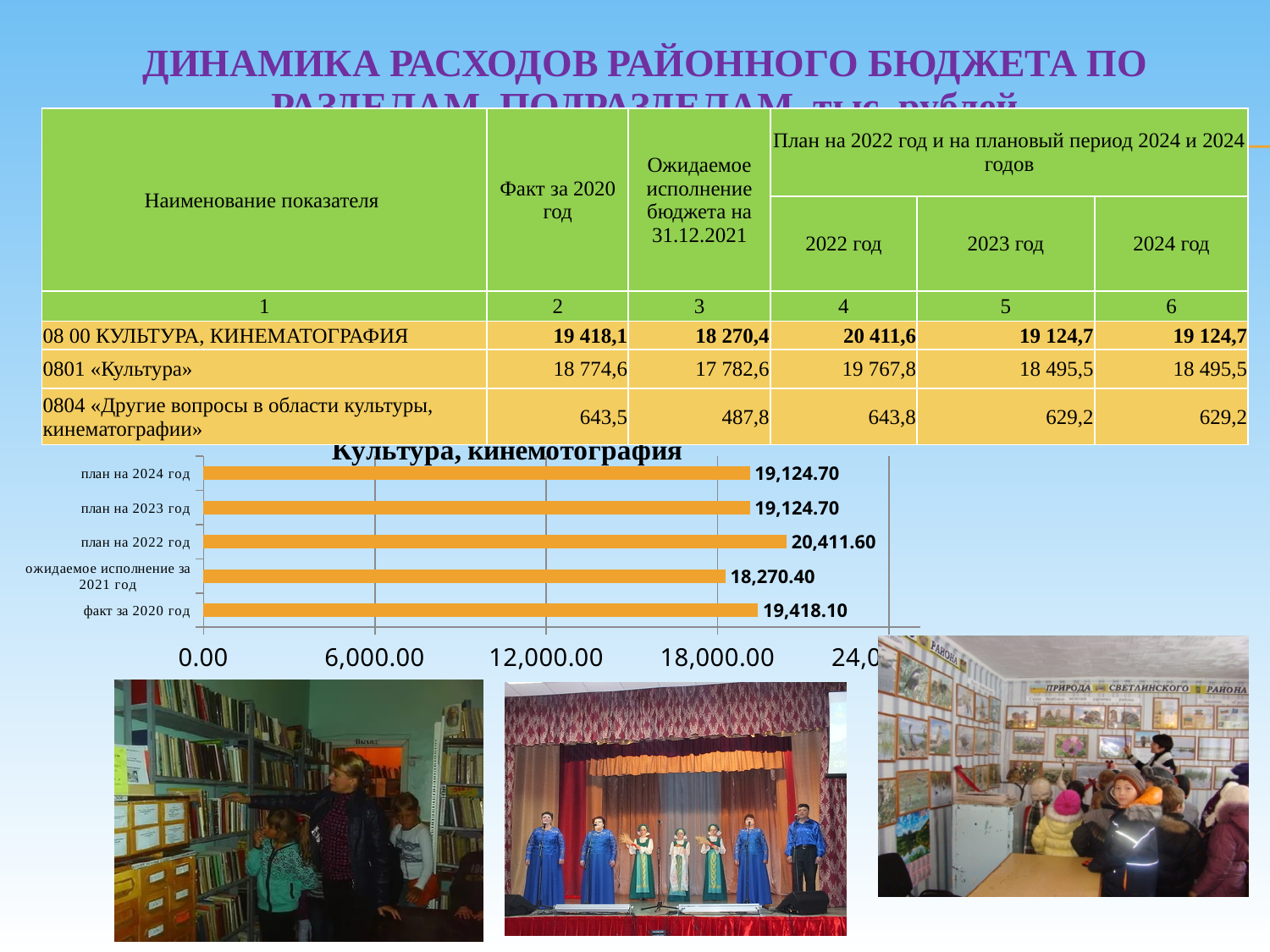
What type of chart is shown on the slide? bar chart Is the value for 'ожидаемое исполнение за 2021 год' greater or less than 18,000.00? greater What value is shown for 'план на 2022 год' in the chart? 20,411.60 What is the difference between the values for 'факт за 2020 год' and 'план на 2023 год'? 293.40 How many categories (bars) are shown in the chart? 5 What value is shown for 'ожидаемое исполнение за 2021 год' in the chart? 18,270.40 What is the difference between the values for 'план на 2022 год' and 'ожидаемое исполнение за 2021 год'? 2,141.20 What value is shown for 'факт за 2020 год' in the chart? 19,418.10 Which category has the highest value in the chart? план на 2022 год Which category has the lowest value in the chart? ожидаемое исполнение за 2021 год Which is larger: the value for 'факт за 2020 год' or the value for 'план на 2023 год'? факт за 2020 год What value is shown for 'план на 2024 год' in the chart? 19,124.70